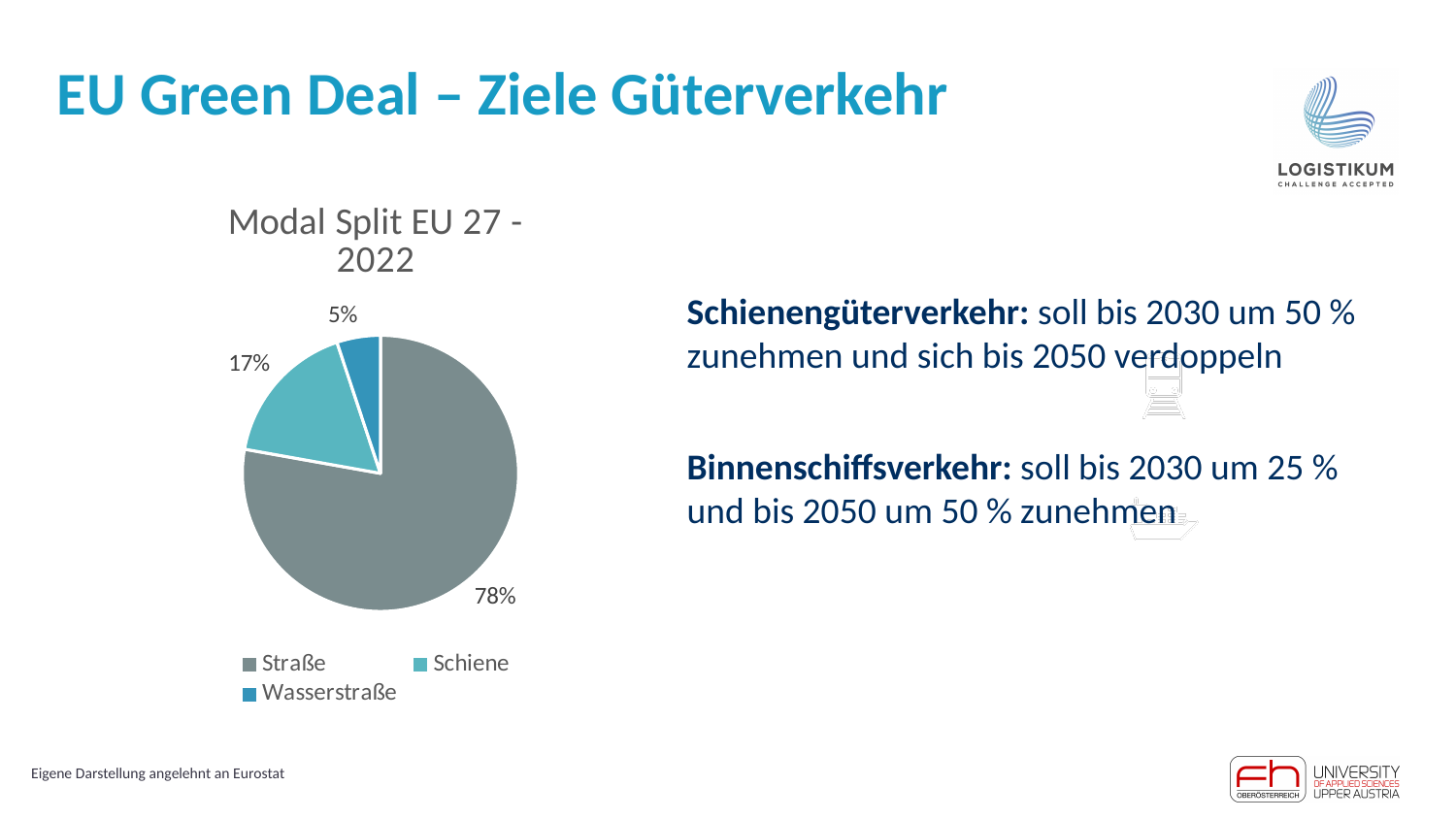
Which is larger, the share for Schiene or the share for Wasserstraße? Schiene What is the difference in percentage points between Straße and Schiene? 61 What share of the pie does Schiene have? 17% Which category has the largest share of the pie? Straße How many entries does the legend list? 3 What share of the pie does Wasserstraße have? 5% What is the title of the chart? Modal Split EU 27 - 2022 What kind of chart is shown on the slide? pie chart What is the difference in percentage points between Schiene and Wasserstraße? 12 Which category has the smallest share of the pie? Wasserstraße What share of the pie does Straße have? 78% How many categories does the pie chart show? 3